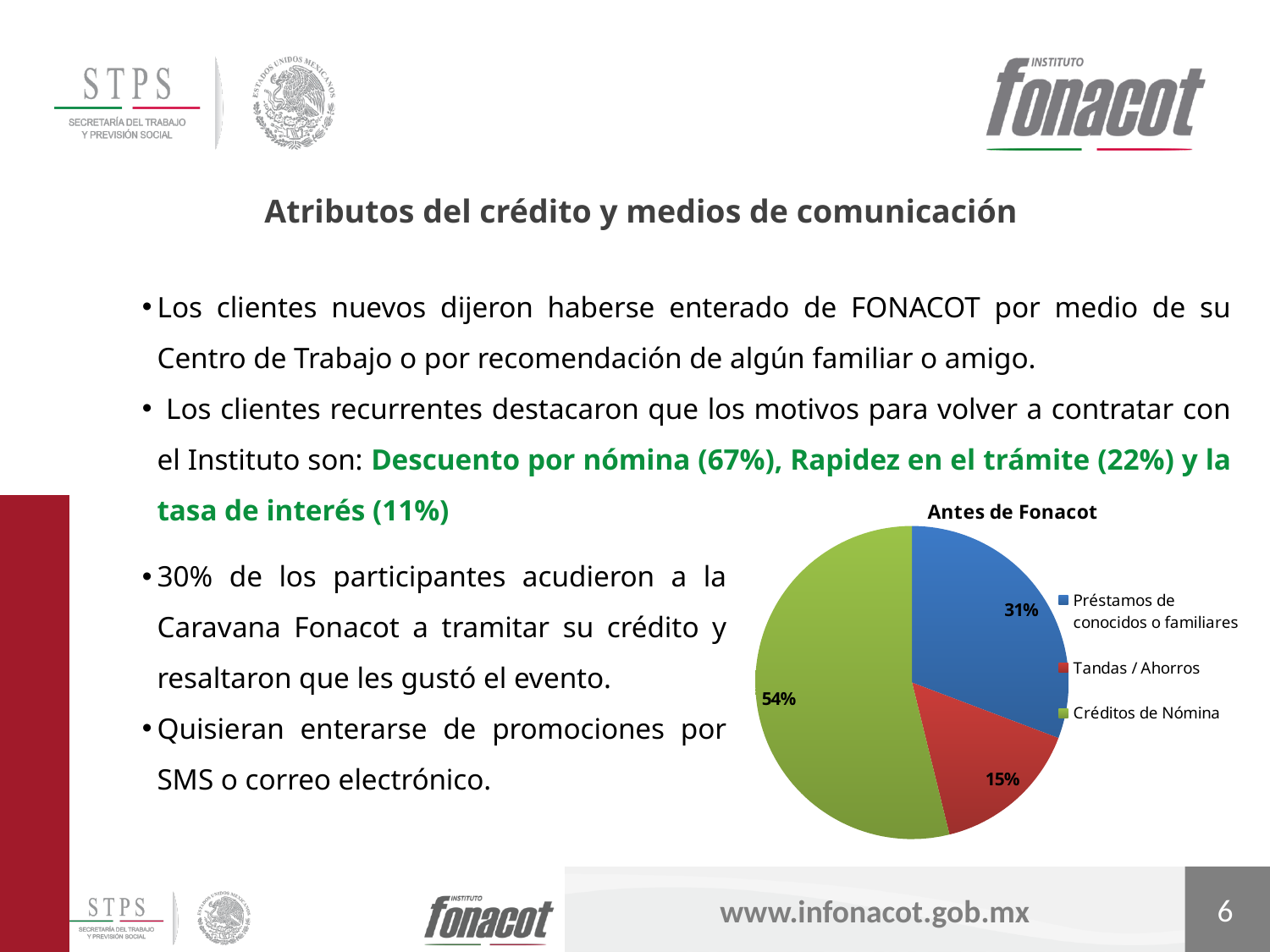
What is the difference between the Préstamos de conocidos o familiares share and the Tandas / Ahorros share? 16% What is the difference between the Créditos de Nómina share and the Préstamos de conocidos o familiares share? 23% What is the value shown for Préstamos de conocidos o familiares? 31% Which category has the smallest slice of the pie? Tandas / Ahorros Which category has the largest slice of the pie? Créditos de Nómina What share of the pie does Créditos de Nómina represent? 54% What type of chart is shown on the slide? Pie chart How many categories does the pie chart show? 3 What colour is the Créditos de Nómina slice? Green Which is larger, the share for Préstamos de conocidos o familiares or the share for Tandas / Ahorros? Préstamos de conocidos o familiares What is the title of the chart? Antes de Fonacot What is the value shown for Tandas / Ahorros? 15%